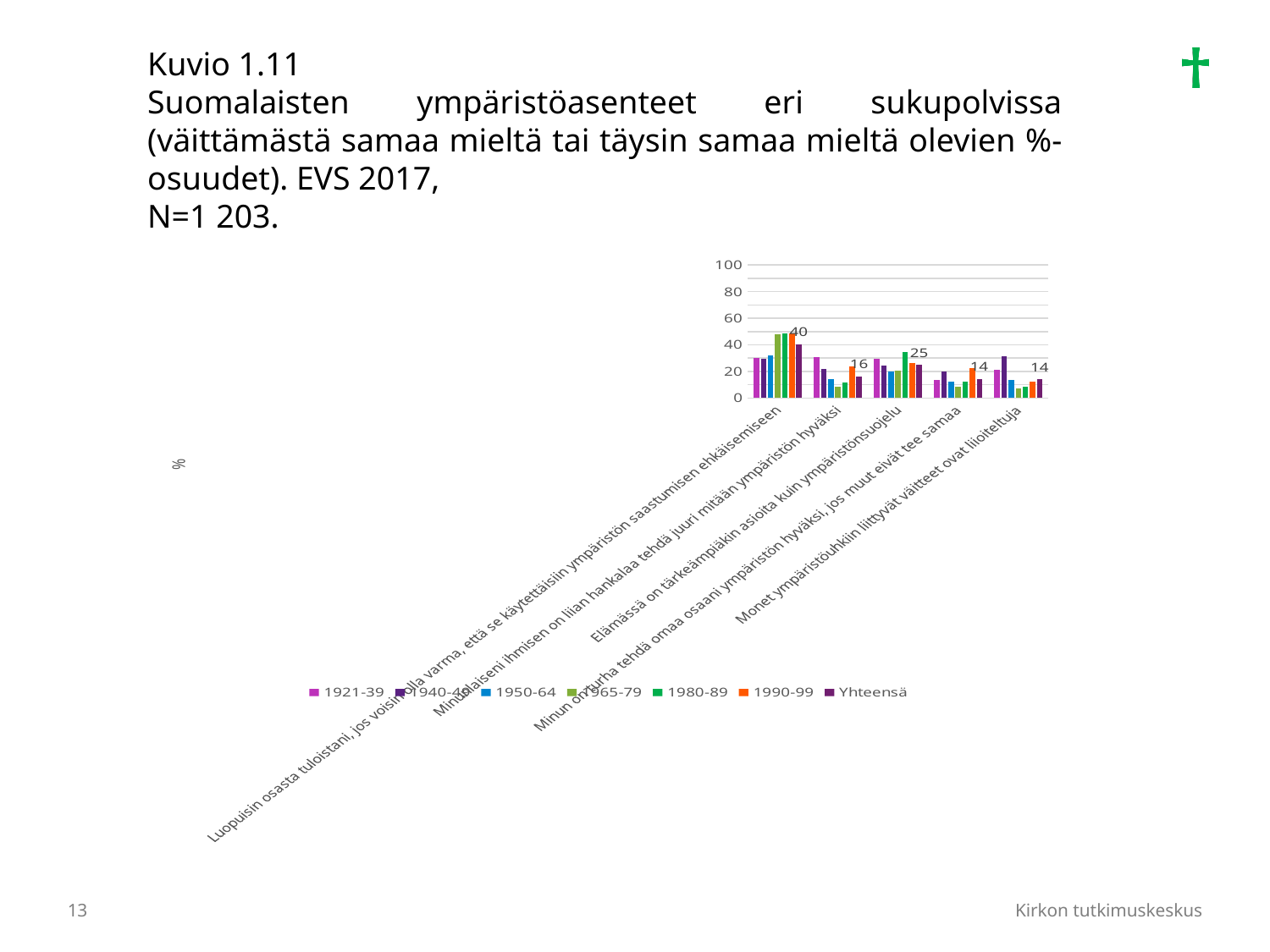
Which has the larger Yhteensä value: "Elämässä on tärkeämpiäkin asioita kuin ympäristönsuojelu" or "Minunlaiseni ihmisen on liian hankalaa tehdä juuri mitään ympäristön hyväksi"? Elämässä on tärkeämpiäkin asioita kuin ympäristönsuojelu How many statement categories are plotted on the x axis? 5 What is the difference between the Yhteensä values for "Luopuisin osasta tuloistani..." (40) and "Elämässä on tärkeämpiäkin asioita kuin ympäristönsuojelu" (25)? 15 How many series does the legend list? 7 Which series is listed last in the legend? Yhteensä What kind of chart is shown on the slide? bar chart What is the Yhteensä value for the statement "Luopuisin osasta tuloistani, jos voisin olla varma, että se käytettäisiin ympäristön saastumisen ehkäisemiseen"? 40 Which statement has the highest Yhteensä value? Luopuisin osasta tuloistani, jos voisin olla varma, että se käytettäisiin ympäristön saastumisen ehkäisemiseen What is the Yhteensä value for the statement "Minunlaiseni ihmisen on liian hankalaa tehdä juuri mitään ympäristön hyväksi"? 16 What is the Yhteensä value for the statement "Monet ympäristöuhkiin liittyvät väitteet ovat liioiteltuja"? 14 What is the Yhteensä value for the statement "Elämässä on tärkeämpiäkin asioita kuin ympäristönsuojelu"? 25 Is the value for the 1980-89 series on "Luopuisin osasta tuloistani..." greater or less than 40? greater